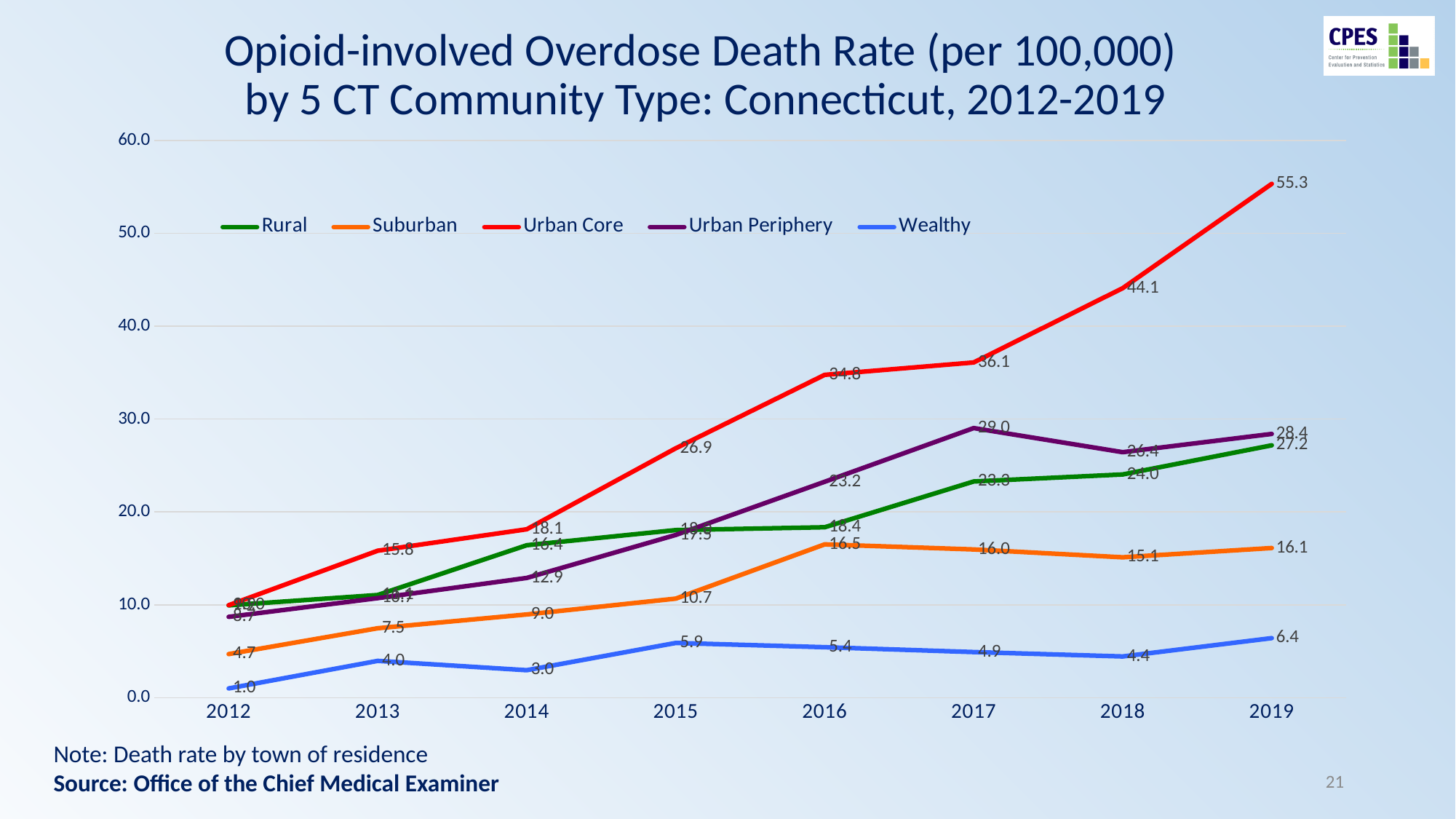
Which community type had the highest death rate in 2019? Urban Core How many years are shown on the x axis? 8 What is the difference between the Urban Core death rate in 2019 and in 2018? 11.2 How many series does the legend list? 5 Which was higher in 2018, the Rural rate or the Urban Periphery rate? Urban Periphery What was the Suburban death rate in 2016? 16.5 Does the Urban Core death rate rise or fall from 2012 to 2019? Rise Which community type had the lowest death rate in 2019? Wealthy What kind of chart is shown on the slide? Line chart What was the opioid-involved overdose death rate for Urban Core in 2019? 55.3 What was the Urban Periphery death rate in 2017? 29.0 What was the death rate for Wealthy communities in 2012? 1.0